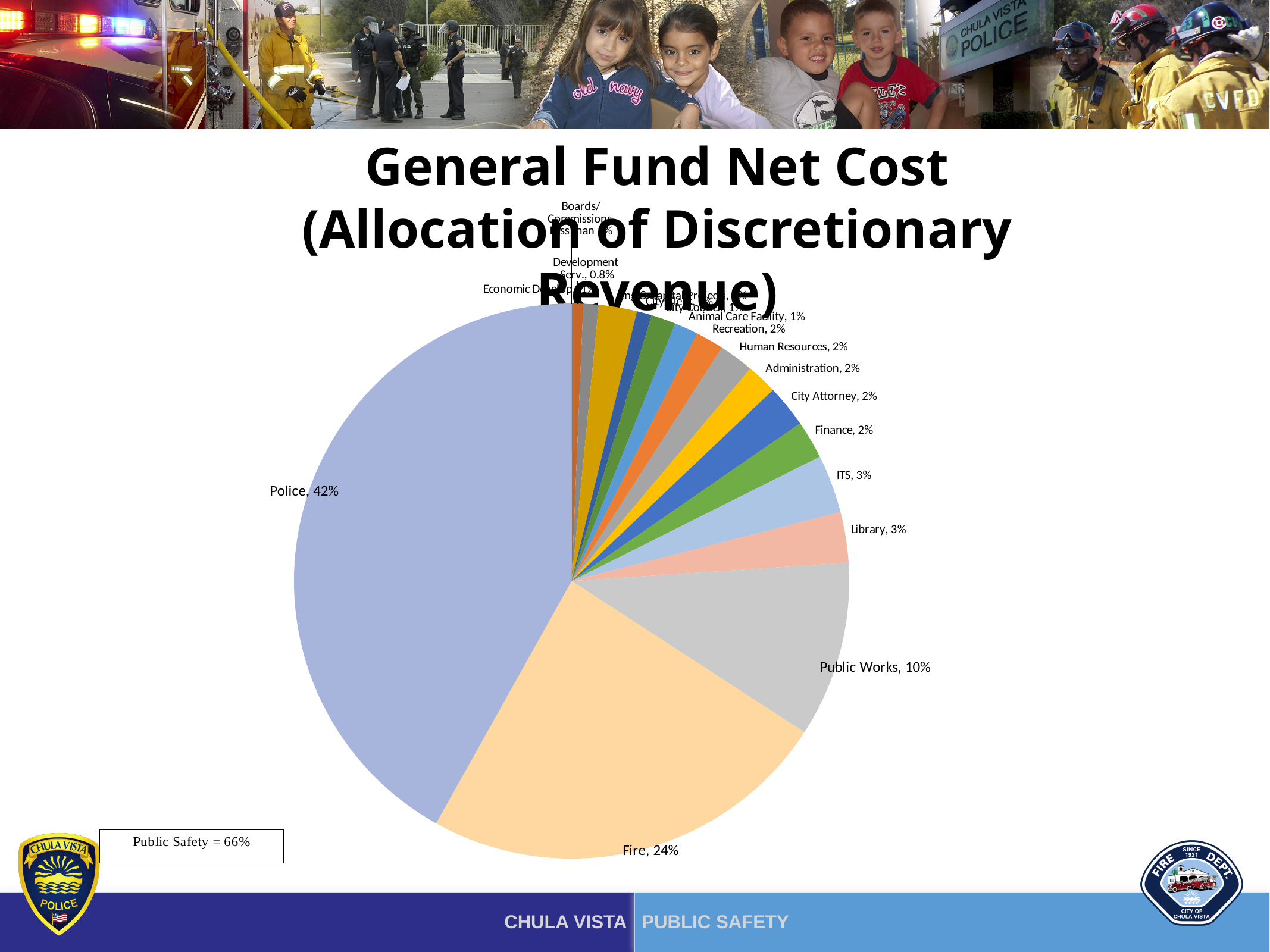
Which is larger, the Fire slice or the Public Works slice? Fire What kind of chart is shown on the slide? pie chart Which category has the largest slice of the pie? Police What is the value shown for Finance? 2% What is the value shown for Development Serv.? 0.8% What is the value shown for Public Works? 10% What is the title of the chart? General Fund Net Cost (Allocation of Discretionary Revenue) What is the difference between the Police share and the Fire share? 18% What is the combined share of Police and Fire? 66% What is the value shown for Fire? 24% What is the value shown for Library? 3% What share of the General Fund Net Cost pie does Police account for? 42%